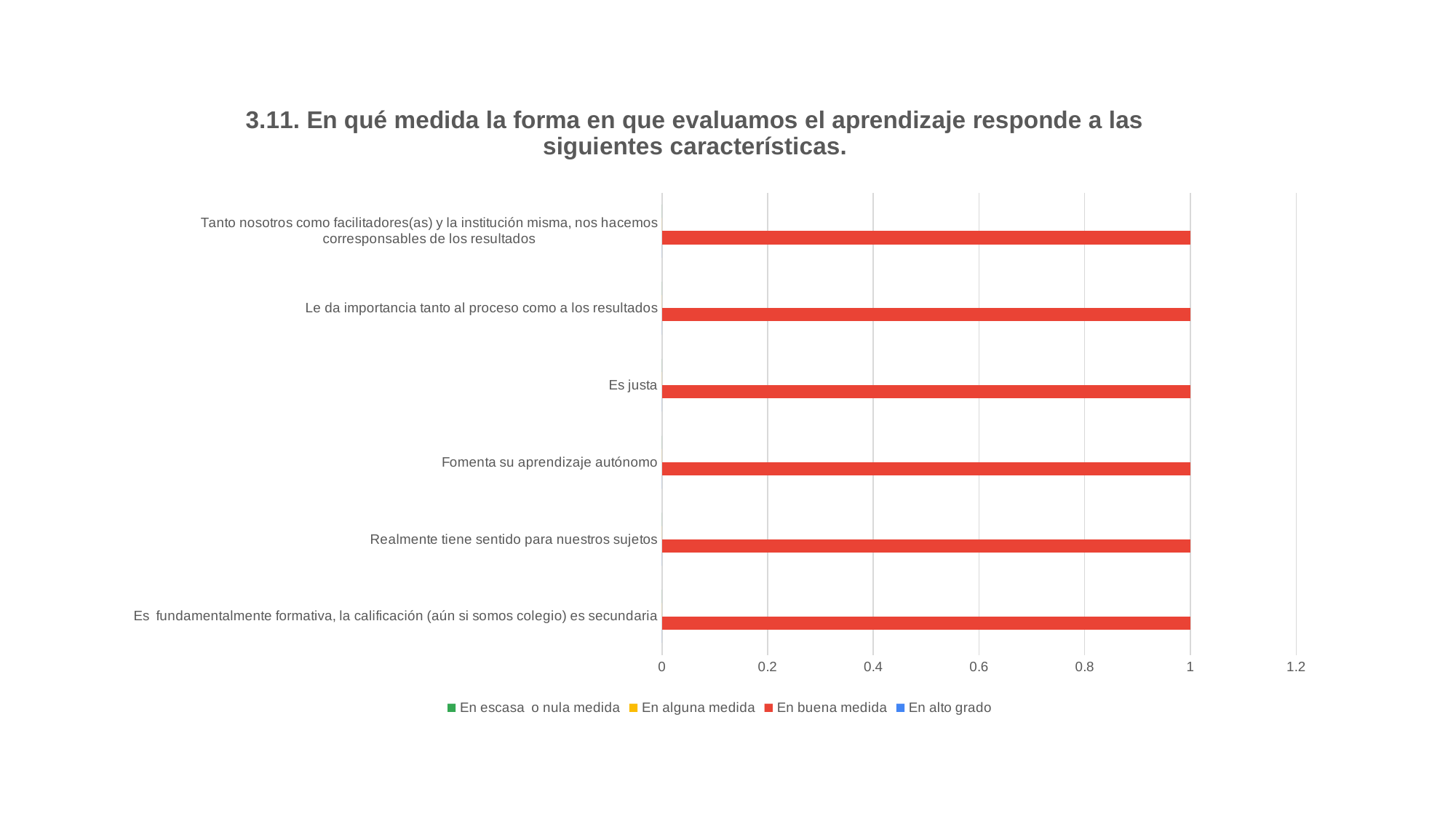
How many categories are plotted on the chart? 6 Is the 'En buena medida' value for 'Le da importancia tanto al proceso como a los resultados' greater or less than 0.6? greater How many series does the legend list? 4 Is the 'En buena medida' value for 'Es justa' greater or less than 1.2? less What is the value of the 'En buena medida' bar for 'Fomenta su aprendizaje autónomo'? 1 Which series in the legend is shown in red? En buena medida What is the difference between the 'En buena medida' values for 'Es justa' and 'Fomenta su aprendizaje autónomo'? 0 What kind of chart is shown on the slide? bar chart What is the title of the chart? 3.11. En qué medida la forma en que evaluamos el aprendizaje responde a las siguientes características. What is the highest value shown on the horizontal axis? 1.2 What is the value of the 'En buena medida' bar for 'Realmente tiene sentido para nuestros sujetos'? 1 What is the value of the 'En buena medida' bar for 'Es justa'? 1